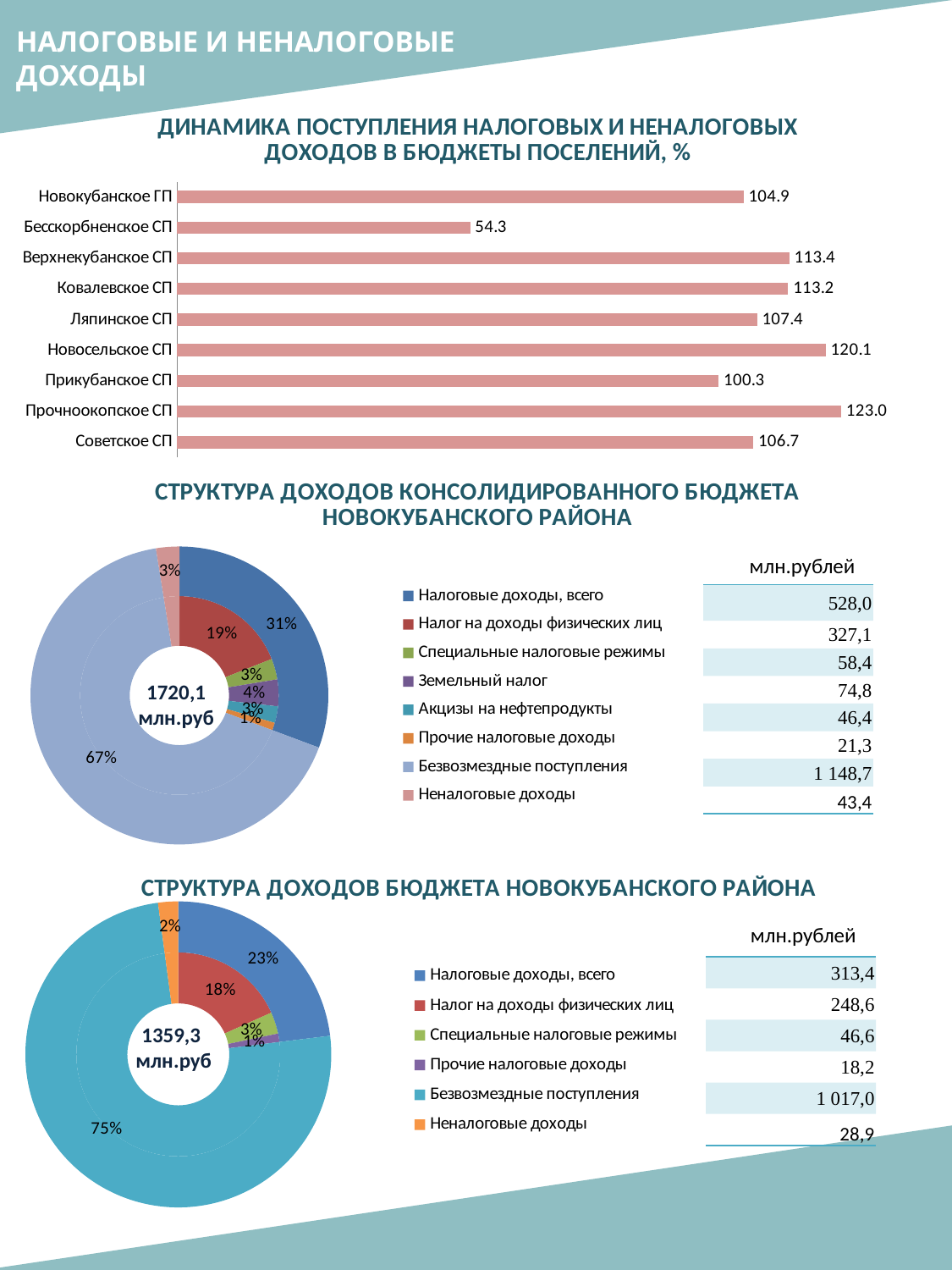
In the bar chart 'Динамика поступления налоговых и неналоговых доходов в бюджеты поселений, %', which settlement has the highest value? Прочноокопское СП In the chart 'Структура доходов консолидированного бюджета Новокубанского района', what is the value in млн.рублей for Налог на доходы физических лиц? 327,1 In the chart 'Структура доходов бюджета Новокубанского района', what share of the total is Налоговые доходы, всего? 23% How many entries does the legend list in the chart 'Структура доходов консолидированного бюджета Новокубанского района'? 8 What total value is shown in the centre of the chart 'Структура доходов бюджета Новокубанского района'? 1359,3 млн.руб In the bar chart 'Динамика поступления налоговых и неналоговых доходов в бюджеты поселений, %', which settlement has the lowest value? Бесскорбненское СП In the bar chart 'Динамика поступления налоговых и неналоговых доходов в бюджеты поселений, %', which is larger: the value for Ляпинское СП or the value for Советское СП? Ляпинское СП In the bar chart 'Динамика поступления налоговых и неналоговых доходов в бюджеты поселений, %', what is the value for Новокубанское ГП? 104.9 What kind of chart is the top chart 'Динамика поступления налоговых и неналоговых доходов в бюджеты поселений, %'? Bar chart How many settlements are shown in the bar chart 'Динамика поступления налоговых и неналоговых доходов в бюджеты поселений, %'? 9 In the bar chart 'Динамика поступления налоговых и неналоговых доходов в бюджеты поселений, %', what is the difference between the values for Новосельское СП and Прикубанское СП? 19.8 In the chart 'Структура доходов консолидированного бюджета Новокубанского района', what share of the total is Безвозмездные поступления? 67%